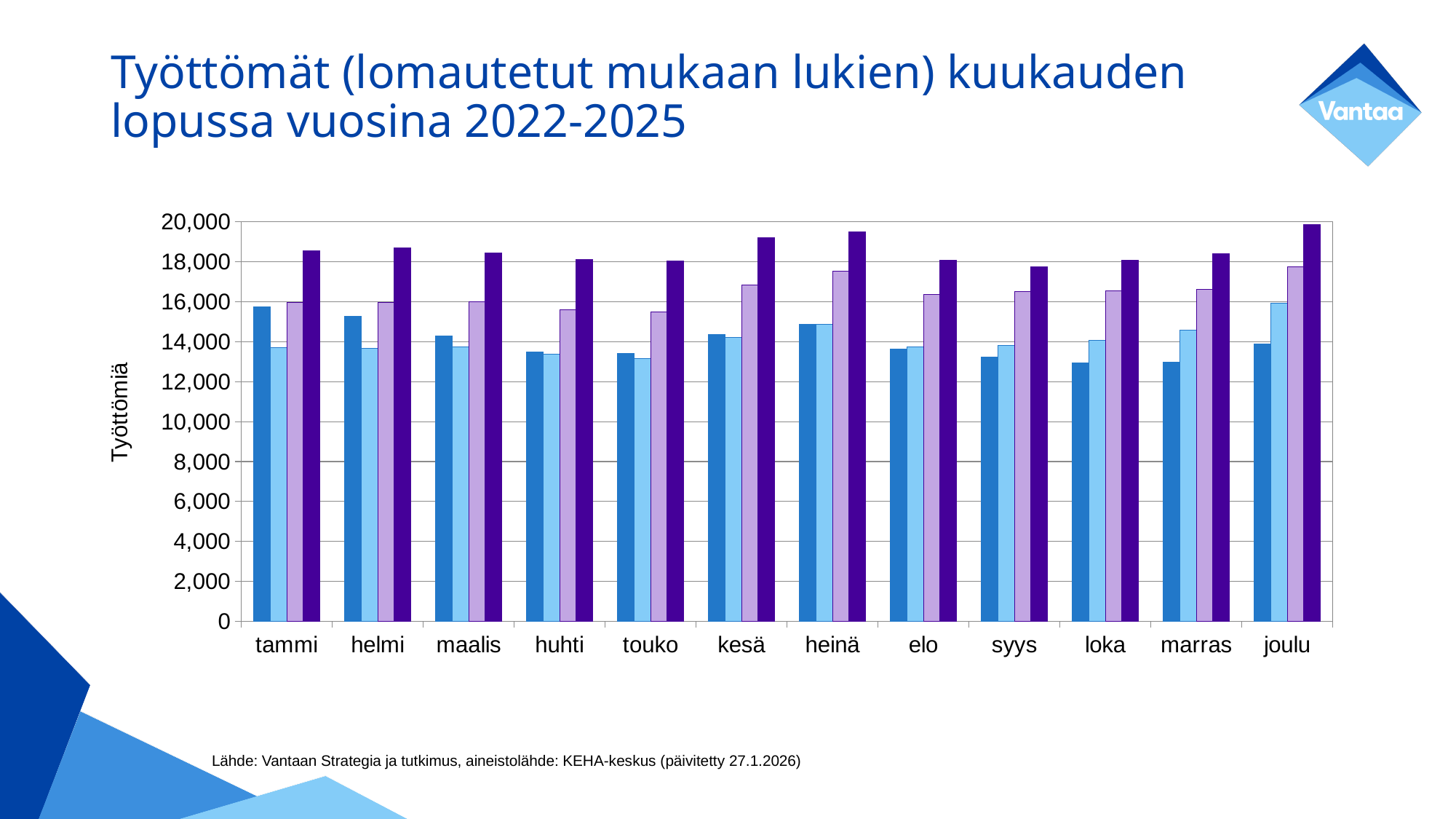
Among the dark purple bars, which month has the highest value? joulu How many bars are plotted for each month? 4 In joulu, which is larger: the lavender bar or the light blue bar? lavender Is the dark blue bar for tammi greater or less than 16,000? less What is the label on the y axis? Työttömiä Among the dark blue bars, which month has the highest value? tammi Is the light blue bar for touko greater or less than 14,000? less What kind of chart is shown on the slide? bar chart Is the dark purple bar for heinä greater or less than 18,000? greater Which years does the chart title say the data covers? 2022-2025 How many months are shown along the x axis? 12